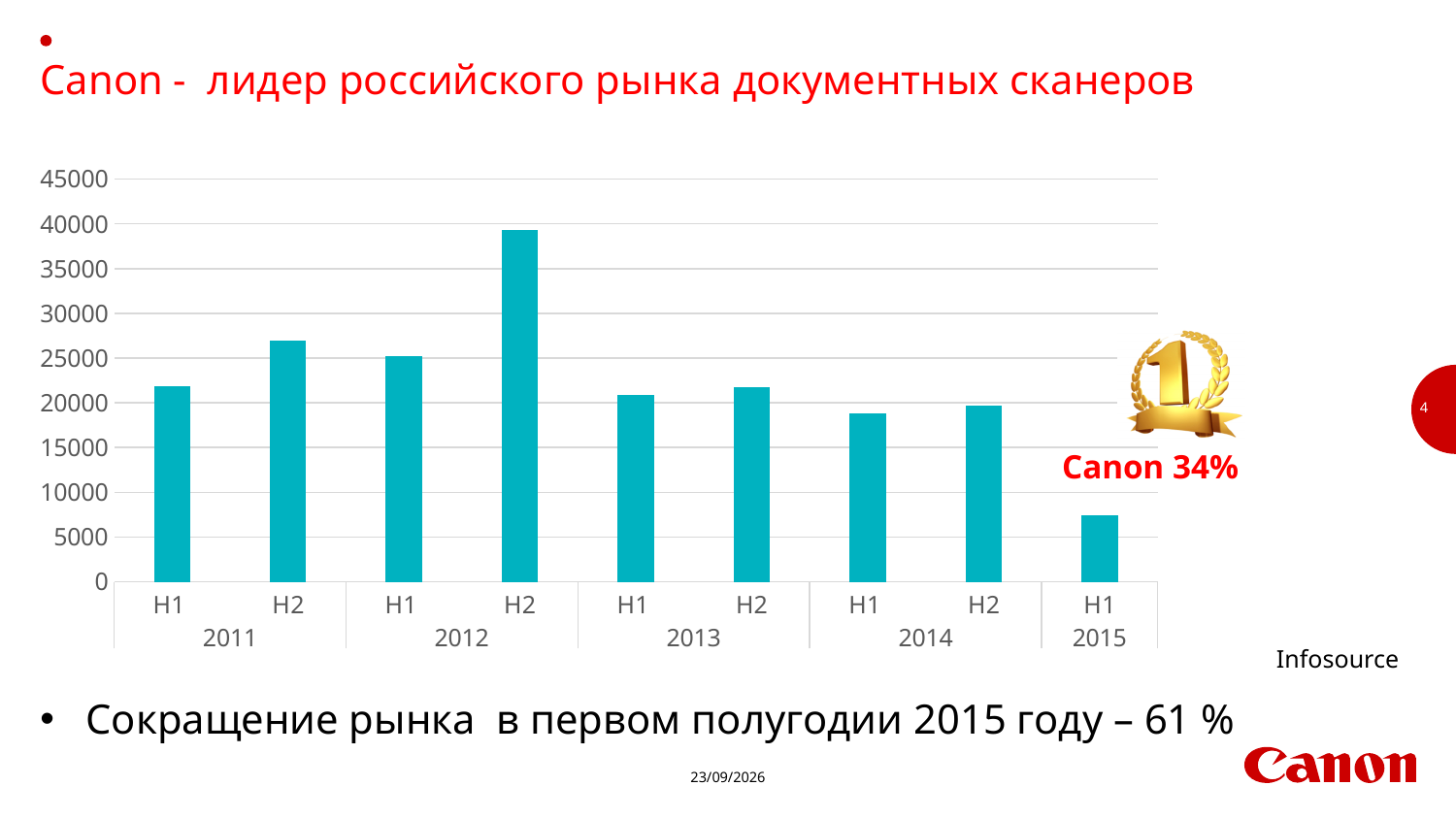
Do the values rise or fall from H2 2012 to H1 2015? fall How many bars are plotted in the chart? 9 Is the value for H1 2014 greater or less than 20000? less Is the value for H1 2015 greater or less than 10000? less What kind of chart is shown on the slide? bar chart Is the value for H2 2012 greater or less than 35000? greater Which period has the lowest value in the chart? H1 2015 Which is larger, the value for H1 2013 or the value for H1 2014? H1 2013 Which period has the highest value in the chart? H2 2012 What source is credited for the chart data? Infosource Which is larger, the value for H1 2012 or the value for H2 2012? H2 2012